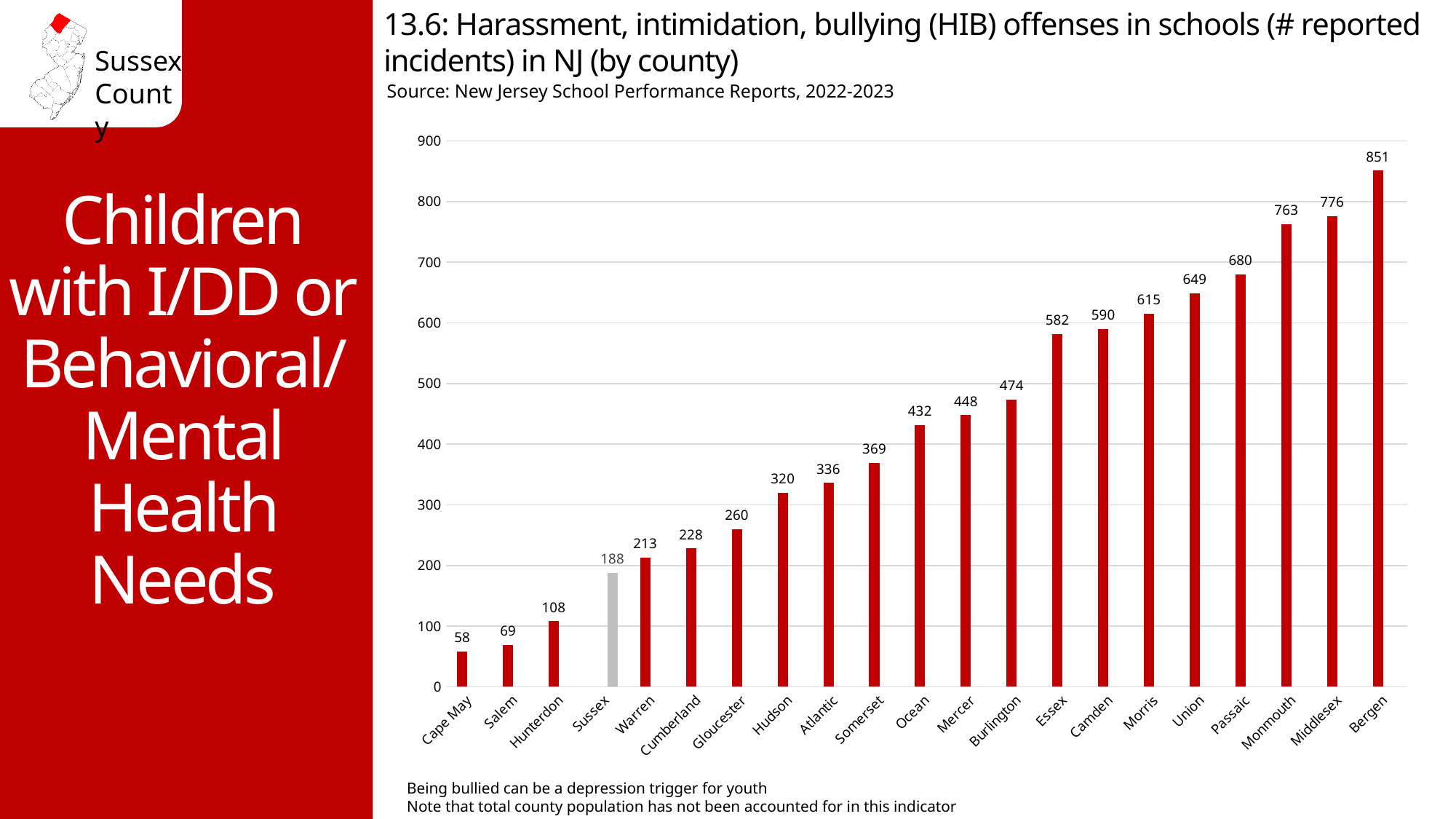
What kind of chart is shown on the slide? Bar chart What is the difference in reported HIB incidents between Middlesex and Monmouth? 13 Which county has the lowest number of reported HIB incidents? Cape May Is the value for Passaic greater or less than 700? less Which county's bar is shown in gray instead of red? Sussex Which county has the highest number of reported HIB incidents? Bergen Which county has more reported HIB incidents, Essex or Ocean? Essex What is the number of reported HIB incidents for Hudson? 320 What is the number of reported HIB incidents for Bergen? 851 What is the difference in reported HIB incidents between Bergen and Sussex? 663 What is the number of reported HIB incidents for Sussex? 188 How many counties are shown on the chart? 21